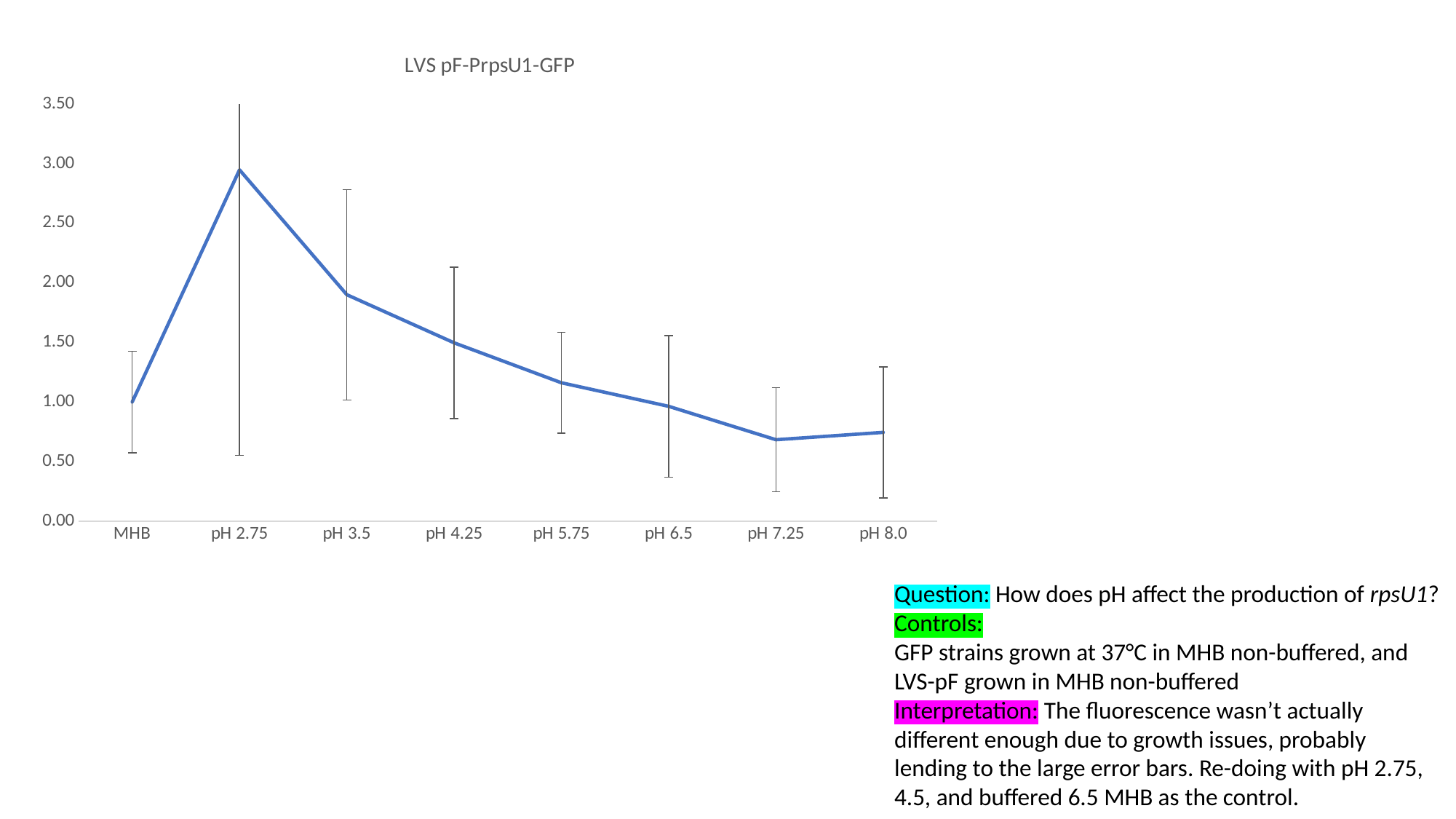
Is the value for pH 3.5 greater or less than 1.50? greater Which has the larger value, pH 3.5 or pH 5.75? pH 3.5 What type of chart is shown on the slide? Line chart What is the first category on the x axis? MHB Do the values rise or fall from pH 2.75 to pH 7.25? fall Is the value for pH 4.25 greater or less than 2.00? less Is the value for pH 2.75 greater or less than 2.50? greater How many categories are plotted along the x axis? 8 Which category has the highest value? pH 2.75 What is the title of the chart? LVS pF-PrpsU1-GFP